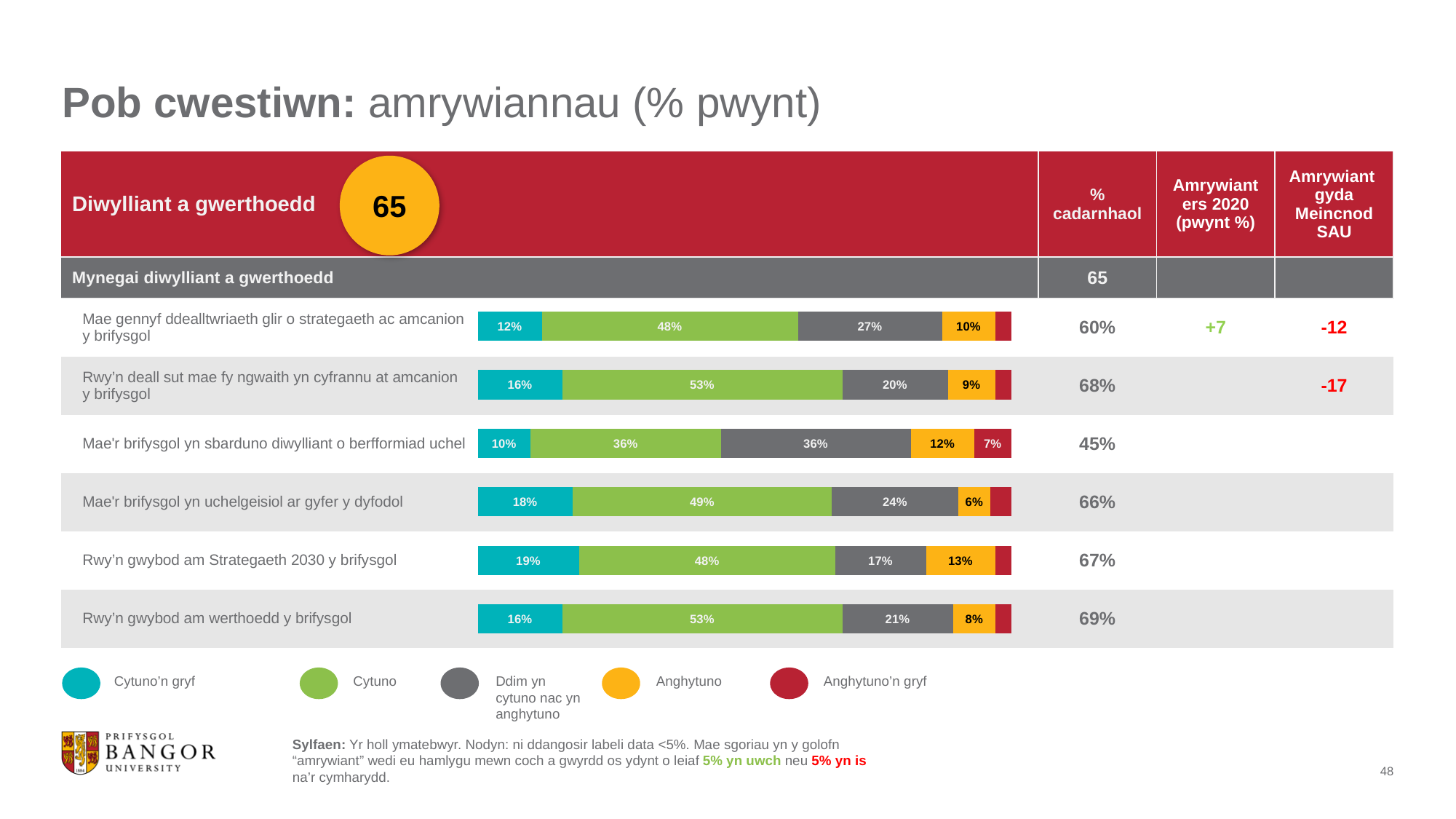
How many series does the legend list? 5 Which statement has the lowest '% cadarnhaol' value? Mae'r brifysgol yn sbarduno diwylliant o berfformiad uchel What percentage of respondents chose 'Cytuno' for 'Rwy'n gwybod am werthoedd y brifysgol'? 53% Which statement has the highest 'Cytuno'n gryf' percentage? Rwy'n gwybod am Strategaeth 2030 y brifysgol How many statements are plotted in the chart? 6 What is the 'Ddim yn cytuno nac yn anghytuno' value for 'Mae'r brifysgol yn sbarduno diwylliant o berfformiad uchel'? 36% What is the difference between the 'Cytuno' values for 'Rwy'n deall sut mae fy ngwaith yn cyfrannu at amcanion y brifysgol' and 'Mae'r brifysgol yn sbarduno diwylliant o berfformiad uchel'? 17% Which is larger: the 'Anghytuno' value for 'Mae gennyf ddealltwriaeth glir o strategaeth ac amcanion y brifysgol' or for 'Mae'r brifysgol yn uchelgeisiol ar gyfer y dyfodol'? Mae gennyf ddealltwriaeth glir o strategaeth ac amcanion y brifysgol What is the 'Anghytuno' value for 'Rwy'n gwybod am Strategaeth 2030 y brifysgol'? 13% What kind of chart is shown on the slide? Stacked bar chart What is the 'Amrywiant gyda Meincnod SAU' value for 'Rwy'n deall sut mae fy ngwaith yn cyfrannu at amcanion y brifysgol'? -17 What is the 'Anghytuno'n gryf' value shown for 'Mae'r brifysgol yn sbarduno diwylliant o berfformiad uchel'? 7%